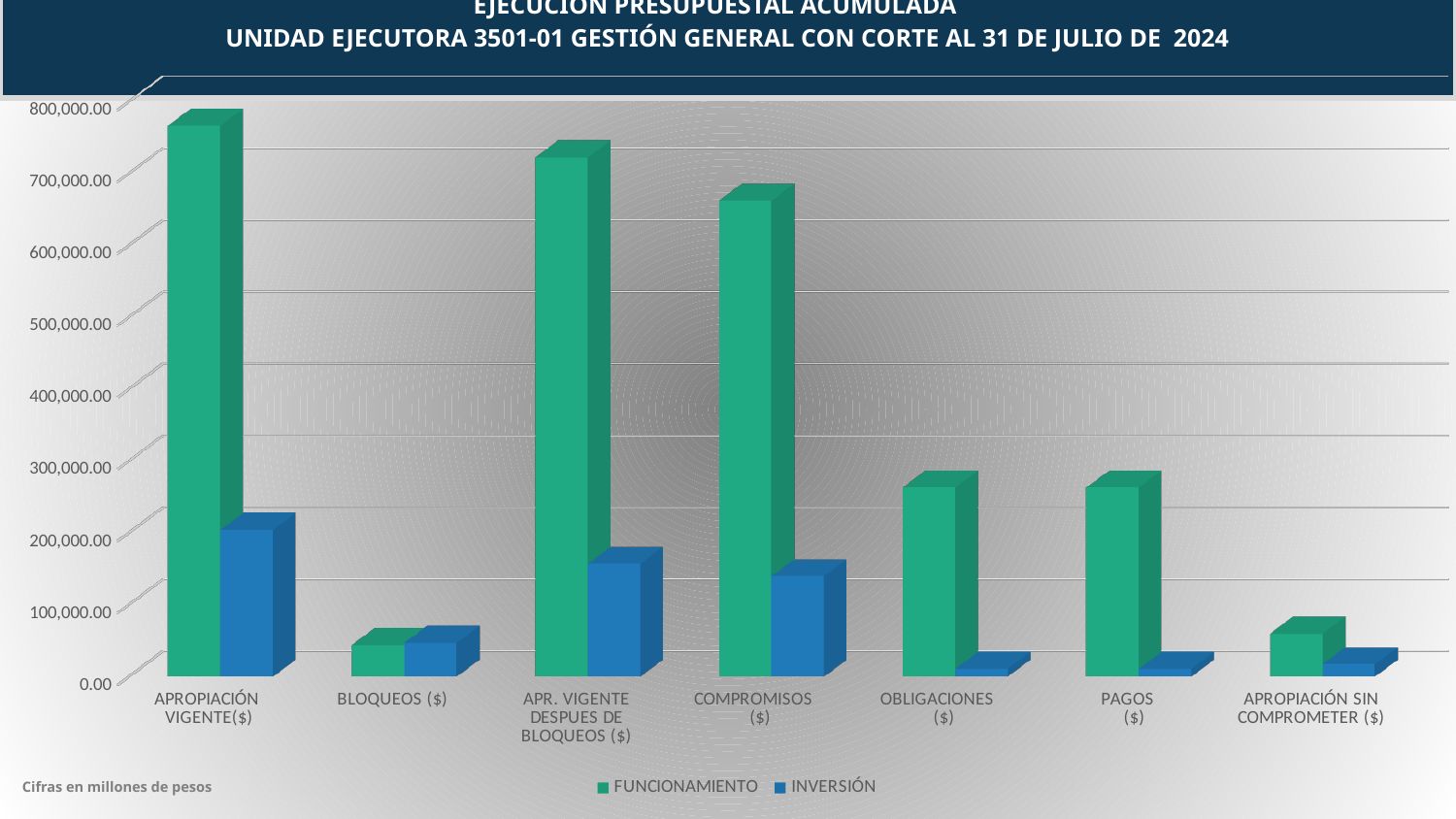
Which category has the highest INVERSIÓN value? APROPIACIÓN VIGENTE($) Is the FUNCIONAMIENTO value for APROPIACIÓN VIGENTE($) greater or less than 700,000.00? greater What kind of chart is shown on the slide? Bar chart For COMPROMISOS ($), which series has the larger value, FUNCIONAMIENTO or INVERSIÓN? FUNCIONAMIENTO Is the INVERSIÓN value for COMPROMISOS ($) greater or less than 100,000.00? greater How many series does the chart legend list? 2 Is the FUNCIONAMIENTO value for BLOQUEOS ($) greater or less than 100,000.00? less How many categories are shown on the x axis of the chart? 7 Which category has the highest FUNCIONAMIENTO value? APROPIACIÓN VIGENTE($) What are the two series named in the chart legend? FUNCIONAMIENTO and INVERSIÓN